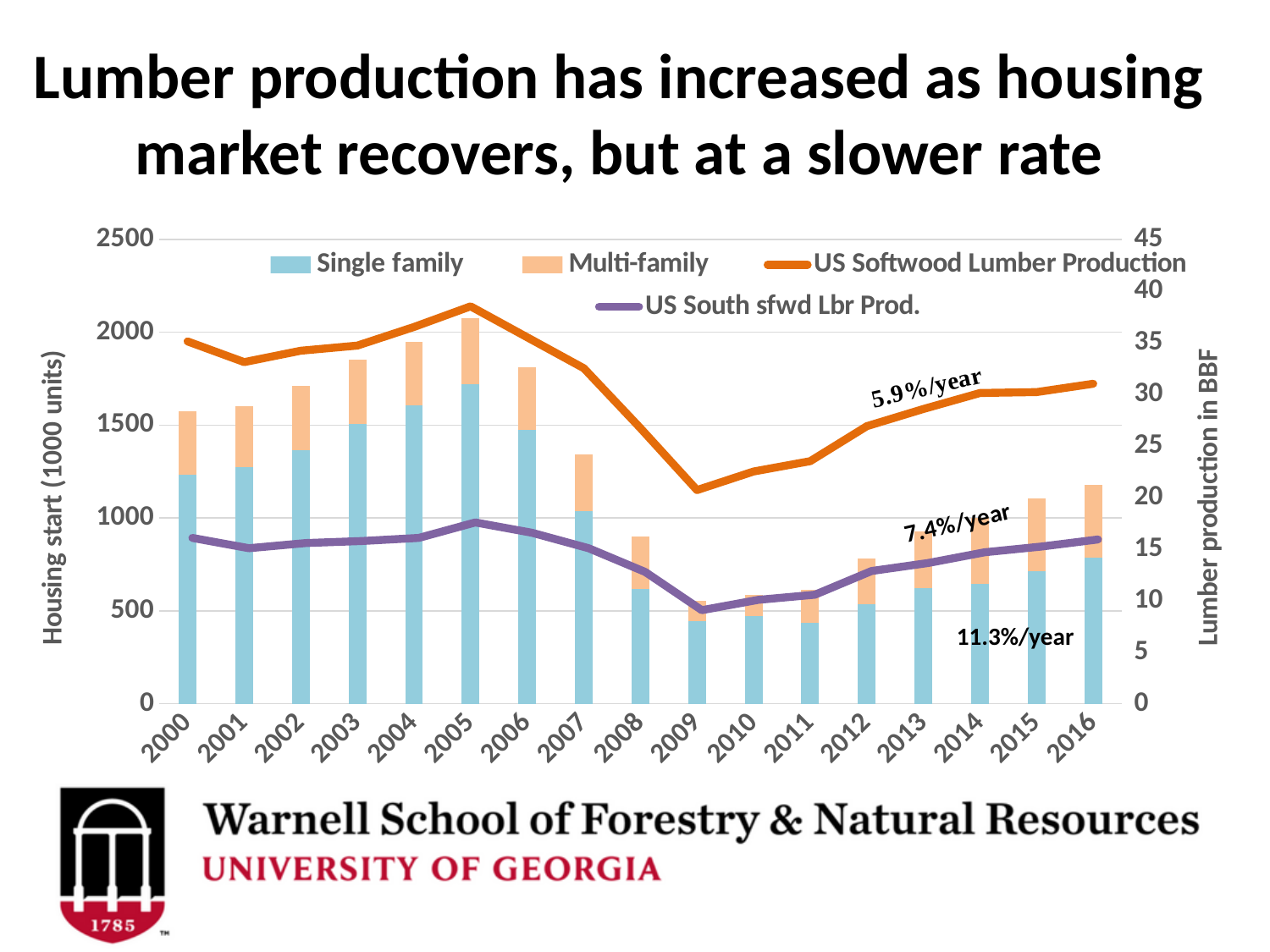
In which year is the total housing start (stacked bar) the highest? 2005 How many years are shown along the x axis of the chart? 17 Which year has the larger total housing start, 2005 or 2009? 2005 What annual growth rate is annotated next to the US Softwood Lumber Production line? 5.9%/year What kind of chart is shown on the slide? Combined stacked bar and line chart Is the total housing start for 2009 greater or less than 1000 (1000 units)? less In which year does the US Softwood Lumber Production line reach its lowest point? 2009 Is the total housing start for 2005 greater or less than 2000 (1000 units)? greater Does the US Softwood Lumber Production line rise or fall from 2009 to 2016? rise In which year is the total housing start (stacked bar) the lowest? 2009 Is the US Softwood Lumber Production value for 2009 greater or less than 25 BBF? less How many series does the chart legend list? 4